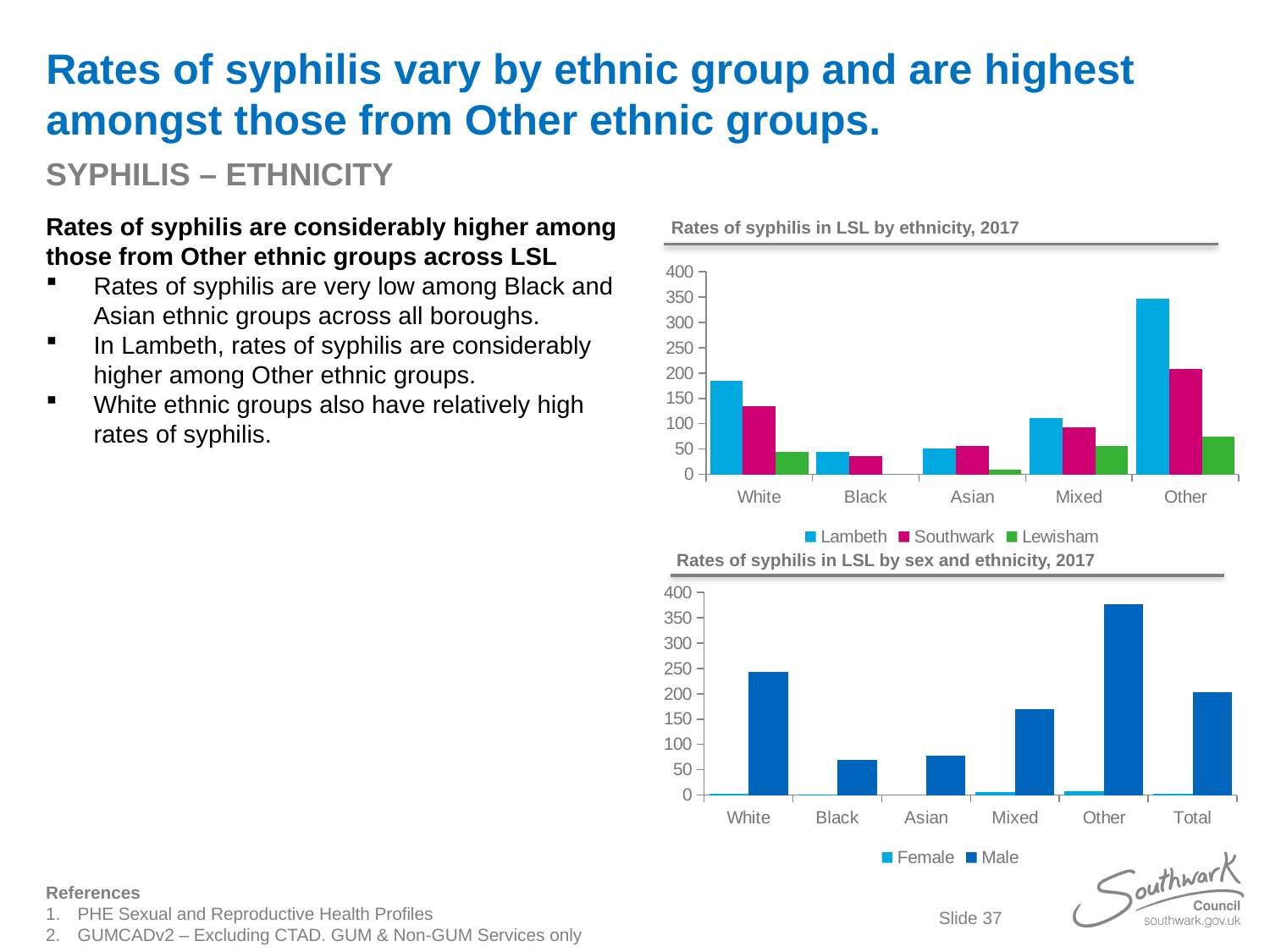
In the chart 'Rates of syphilis in LSL by sex and ethnicity, 2017', how many categories are shown on the x axis? 6 In the chart 'Rates of syphilis in LSL by ethnicity, 2017', is the Lambeth value for Other greater or less than 300? greater In the chart 'Rates of syphilis in LSL by ethnicity, 2017', how many ethnic groups are shown on the x axis? 5 In the chart 'Rates of syphilis in LSL by sex and ethnicity, 2017', which category has the highest Male value? Other In the chart 'Rates of syphilis in LSL by sex and ethnicity, 2017', is the Male value for Total greater or less than 150? greater In the chart 'Rates of syphilis in LSL by ethnicity, 2017', is the Southwark value for White greater or less than 100? greater What kind of chart is 'Rates of syphilis in LSL by sex and ethnicity, 2017'? Bar chart In the chart 'Rates of syphilis in LSL by ethnicity, 2017', how many series does the legend list? 3 In the chart 'Rates of syphilis in LSL by ethnicity, 2017', which borough has the lowest value for the Other ethnic group? Lewisham In the chart 'Rates of syphilis in LSL by ethnicity, 2017', which is larger for the Mixed group, Lambeth or Southwark? Lambeth In the chart 'Rates of syphilis in LSL by ethnicity, 2017', which ethnic group has the highest value for Lambeth? Other In the chart 'Rates of syphilis in LSL by sex and ethnicity, 2017', which is larger for White, Female or Male? Male